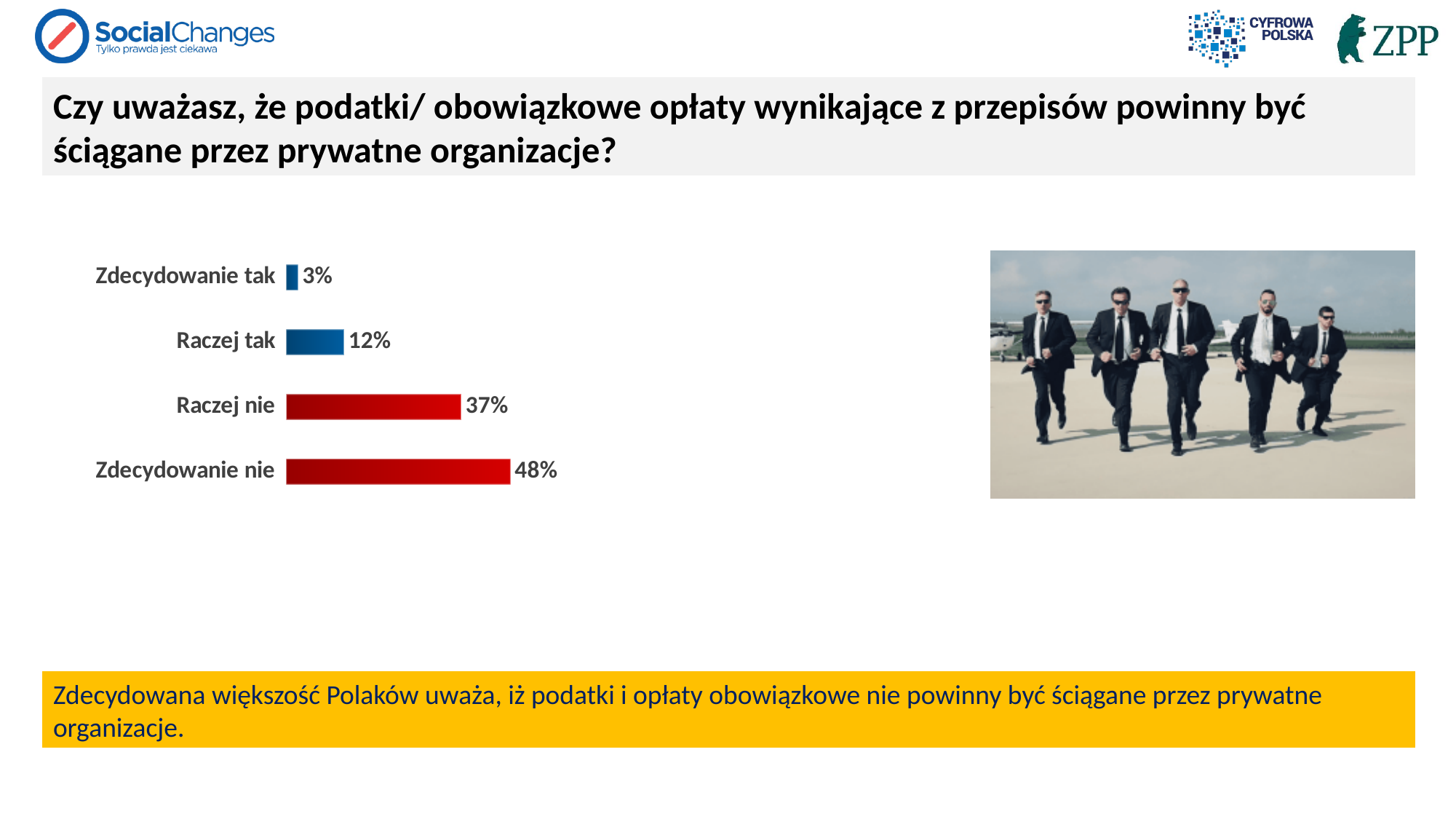
What is the difference between the values for "Zdecydowanie nie" and "Raczej nie"? 11% What is the difference between the values for "Raczej tak" and "Zdecydowanie tak"? 9% What colour are the bars for the "nie" (no) answers? Red What kind of chart is shown on the slide? Bar chart Which is larger, the value for "Raczej nie" or the value for "Raczej tak"? Raczej nie How many categories are shown in the chart? 4 What is the value for "Zdecydowanie tak"? 3% What is the value for "Raczej tak"? 12% Which category has the lowest value? Zdecydowanie tak What is the value for "Zdecydowanie nie"? 48% What is the value for "Raczej nie"? 37% Which category has the highest value? Zdecydowanie nie